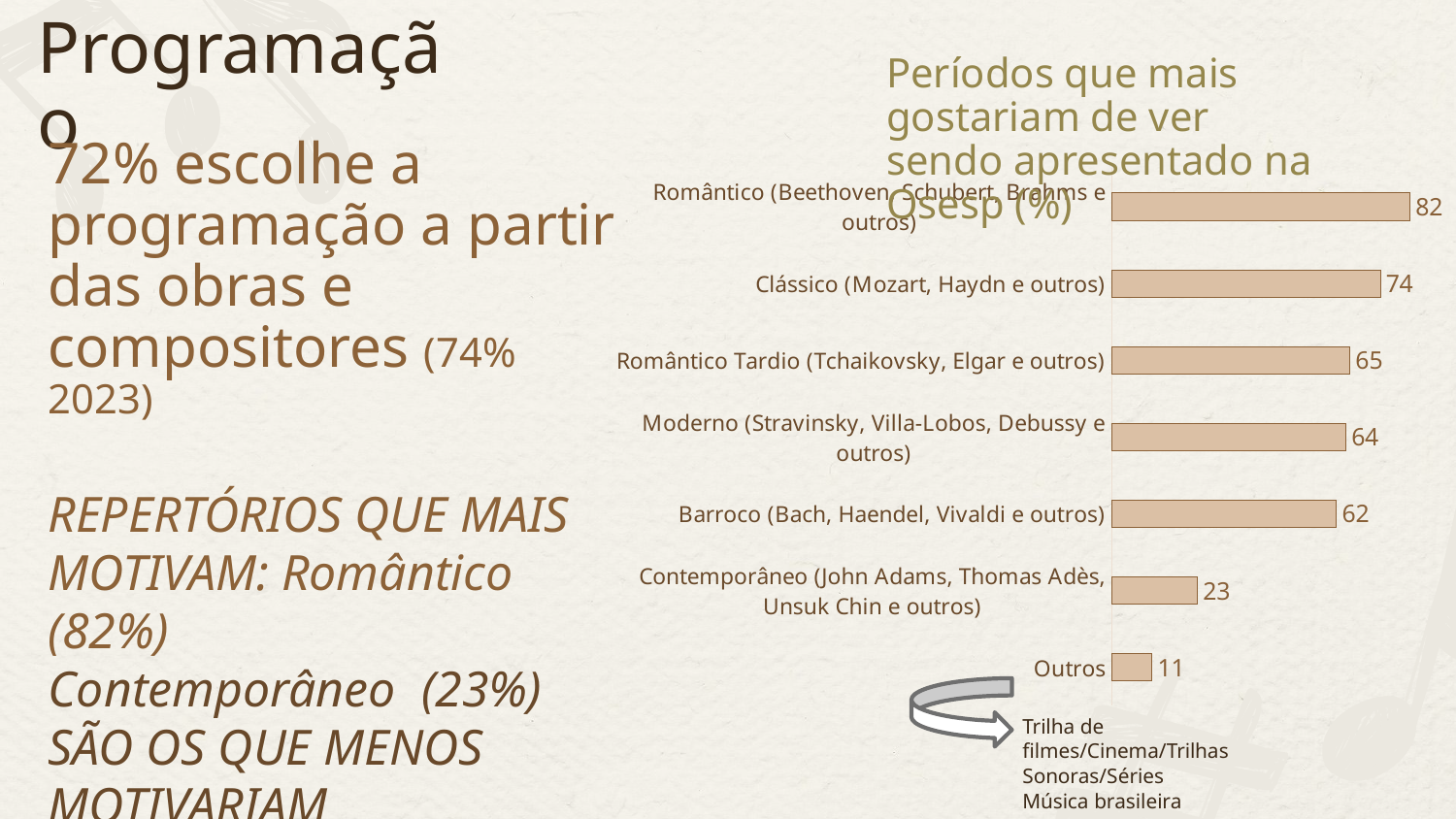
What is the title of the chart? Períodos que mais gostariam de ver sendo apresentado na Osesp (%) What is the difference between the values for Clássico (Mozart, Haydn e outros) and Romântico Tardio (Tchaikovsky, Elgar e outros)? 9 What value is shown for Barroco (Bach, Haendel, Vivaldi e outros)? 62 How many categories are shown in the chart? 7 What is the difference between the values for Romântico (Beethoven, Schubert, Brahms e outros) and Contemporâneo (John Adams, Thomas Adès, Unsuk Chin e outros)? 59 What value is shown for Contemporâneo (John Adams, Thomas Adès, Unsuk Chin e outros)? 23 Which category has the lowest value? Outros What value is shown for Outros? 11 What kind of chart is shown on the slide? Bar chart Which category has the highest value? Romântico (Beethoven, Schubert, Brahms e outros) Which is larger, the value for Moderno (Stravinsky, Villa-Lobos, Debussy e outros) or the value for Barroco (Bach, Haendel, Vivaldi e outros)? Moderno (Stravinsky, Villa-Lobos, Debussy e outros) What value is shown for Clássico (Mozart, Haydn e outros)? 74